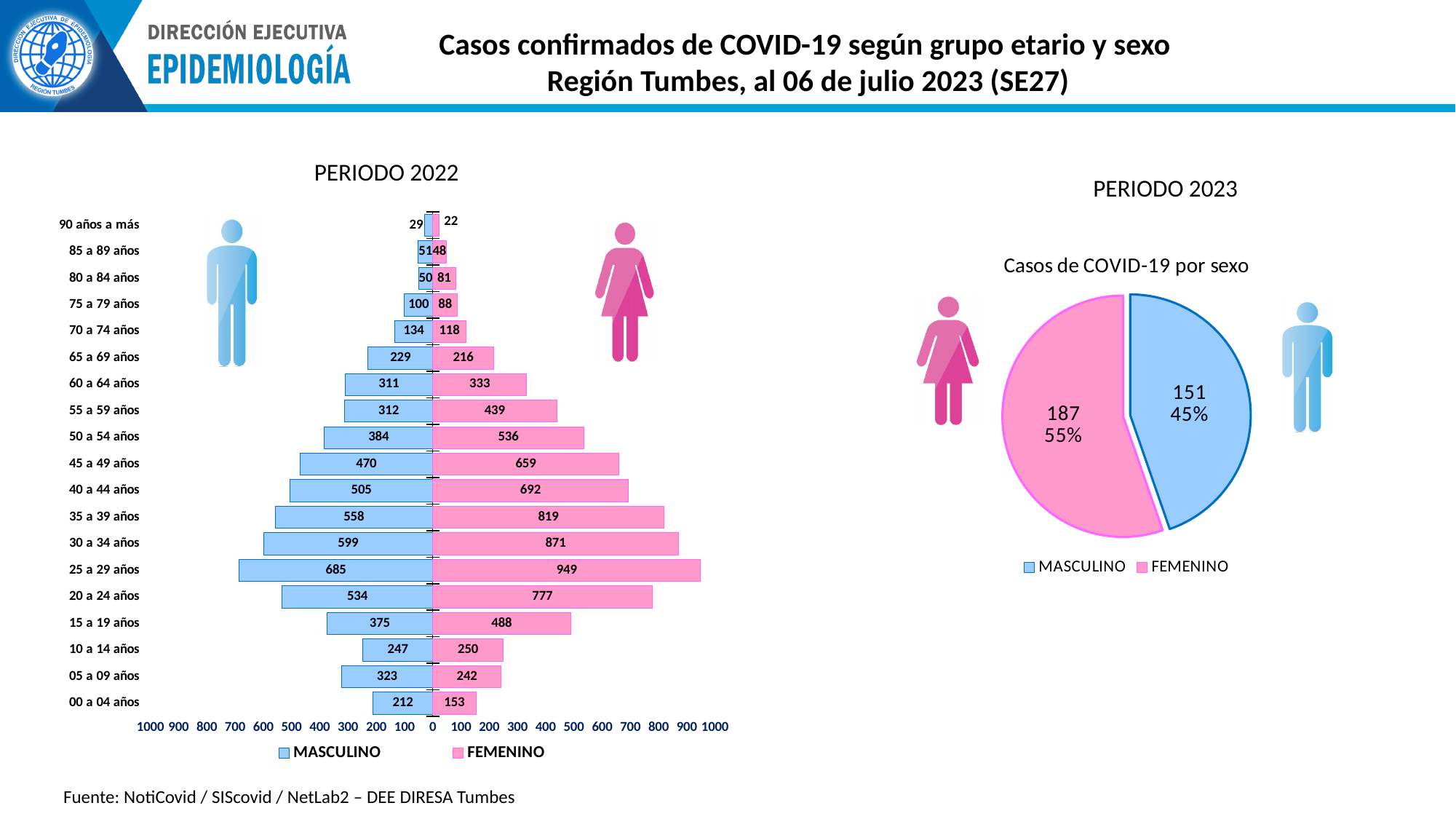
How many series does the legend of the PERIODO 2022 chart list? 2 In the PERIODO 2023 pie chart, what share of cases is MASCULINO? 45% In the PERIODO 2022 chart, which is larger for the 05 a 09 años group, MASCULINO or FEMENINO? MASCULINO In the PERIODO 2022 chart, which age group has the lowest number of MASCULINO cases? 90 años a más In the PERIODO 2022 chart, how many FEMENINO cases are shown for the 25 a 29 años group? 949 What is the title of the PERIODO 2023 pie chart? Casos de COVID-19 por sexo In the PERIODO 2022 chart, which age group has the highest number of FEMENINO cases? 25 a 29 años In the PERIODO 2023 pie chart, how many FEMENINO cases are shown? 187 In the PERIODO 2022 chart, how many MASCULINO cases are shown for the 45 a 49 años group? 470 What kind of chart is the PERIODO 2022 chart? Bar chart In the PERIODO 2022 chart, what is the difference between FEMENINO and MASCULINO cases in the 30 a 34 años group? 272 How many age groups are shown in the PERIODO 2022 chart? 19